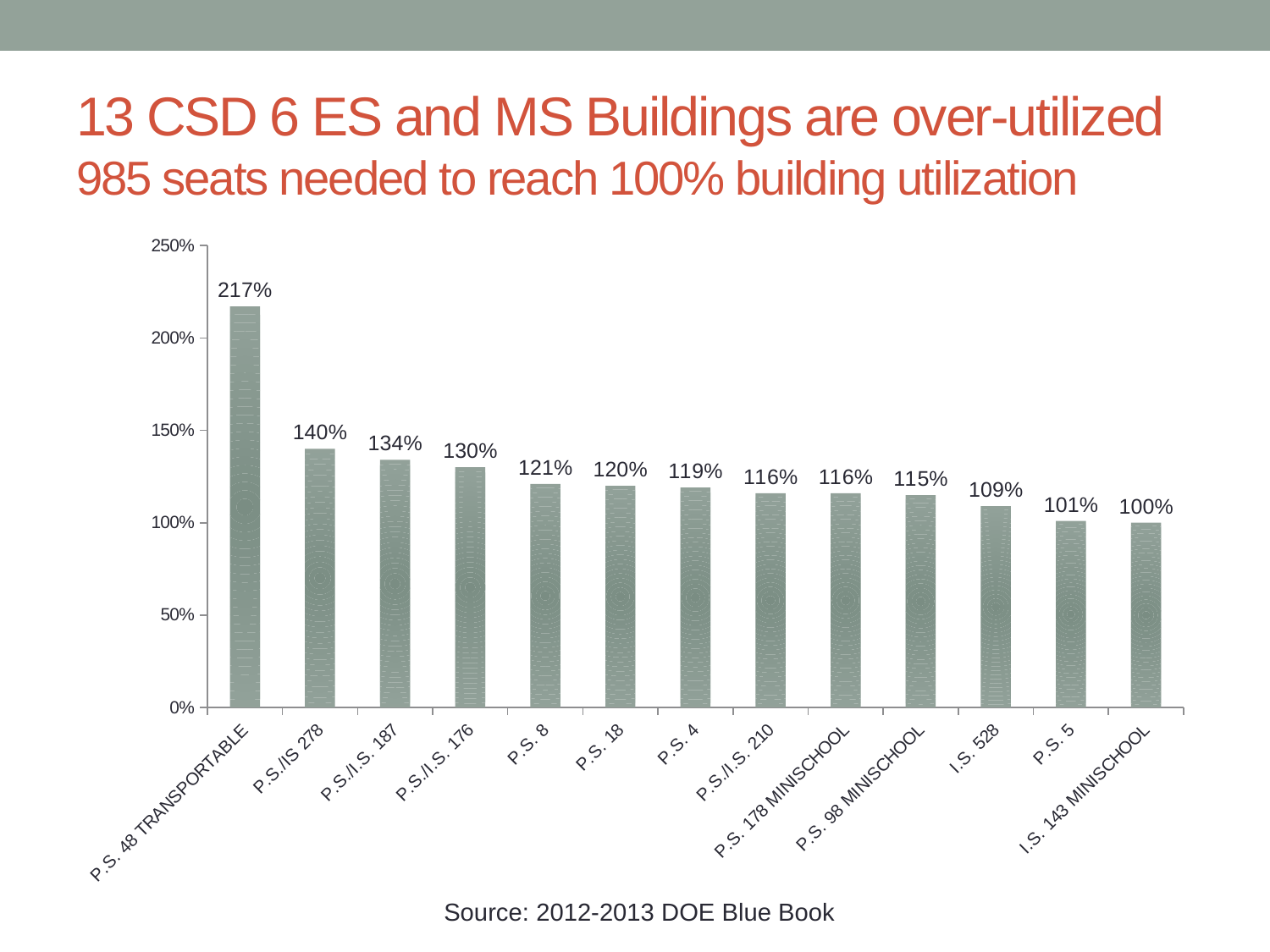
Is the value for P.S./I.S. 176 greater or less than 150%? less Which building has the highest utilization? P.S. 48 TRANSPORTABLE What is the utilization value for P.S./I.S. 187? 134% Do the values rise or fall from left to right along the x axis? fall What kind of chart is shown on the slide? bar chart Which building has the lowest utilization? I.S. 143 MINISCHOOL How many buildings are shown in the chart? 13 What is the utilization value for P.S. 48 TRANSPORTABLE? 217% What is the difference between the utilization of P.S. 48 TRANSPORTABLE and P.S./IS 278? 77% Which has a higher utilization, P.S. 8 or P.S. 5? P.S. 8 What source is cited below the chart? 2012-2013 DOE Blue Book What is the utilization value for I.S. 528? 109%